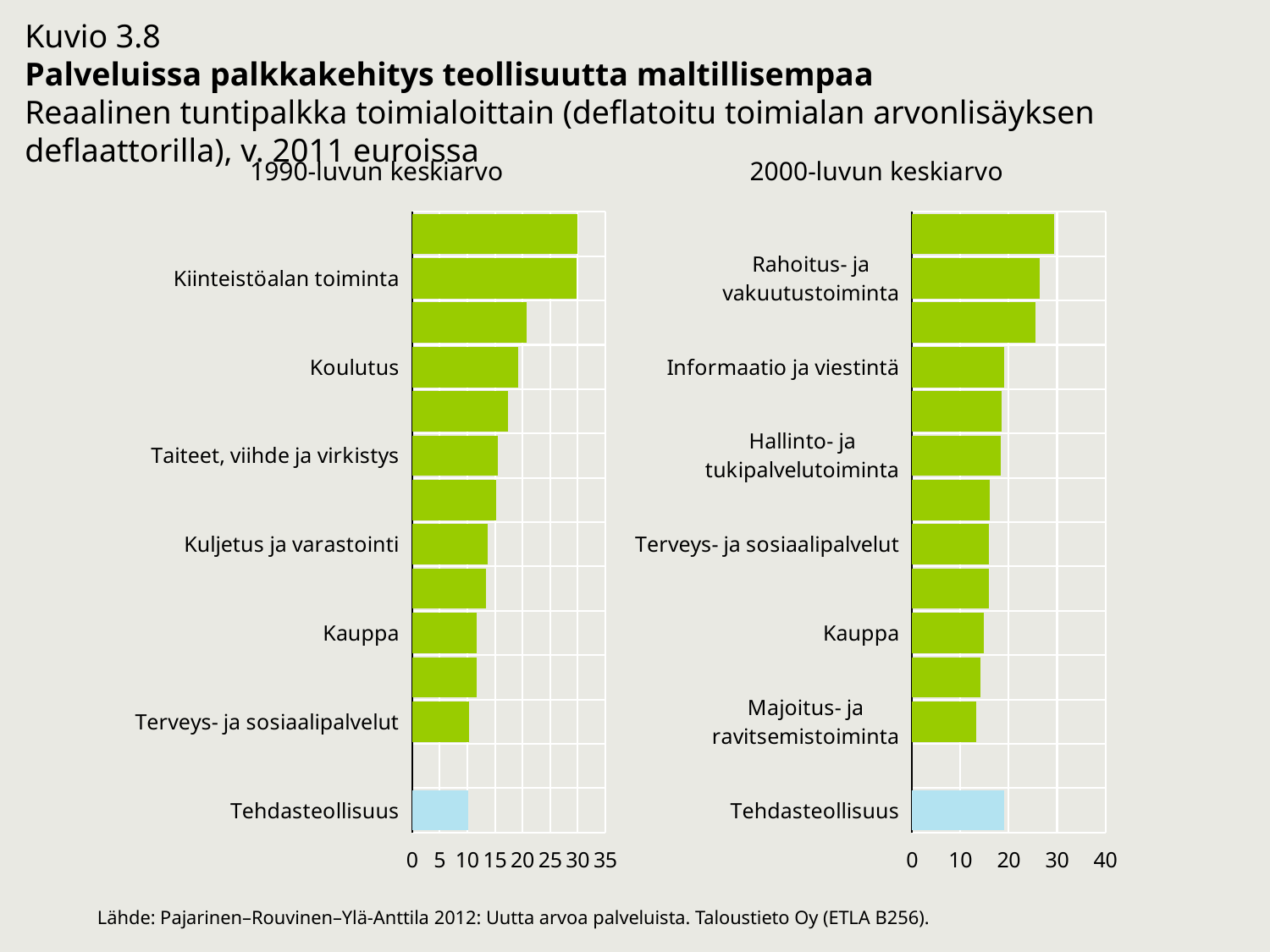
In the '2000-luvun keskiarvo' chart, which is larger, Tehdasteollisuus or Majoitus- ja ravitsemistoiminta? Tehdasteollisuus In the '1990-luvun keskiarvo' chart, is the value for Koulutus greater or less than 15? greater In the '1990-luvun keskiarvo' chart, which is larger, Kiinteistöalan toiminta or Koulutus? Kiinteistöalan toiminta In the '2000-luvun keskiarvo' chart, which is larger, Rahoitus- ja vakuutustoiminta or Kauppa? Rahoitus- ja vakuutustoiminta In the '1990-luvun keskiarvo' chart, is the value for Kiinteistöalan toiminta greater or less than 25? greater In the '2000-luvun keskiarvo' chart, is the value for Rahoitus- ja vakuutustoiminta greater or less than 20? greater In the '2000-luvun keskiarvo' chart, what is the highest value shown on the x axis? 40 What kind of chart is the '1990-luvun keskiarvo' chart? bar chart In the '1990-luvun keskiarvo' chart, what colour is the bar for Tehdasteollisuus? light blue